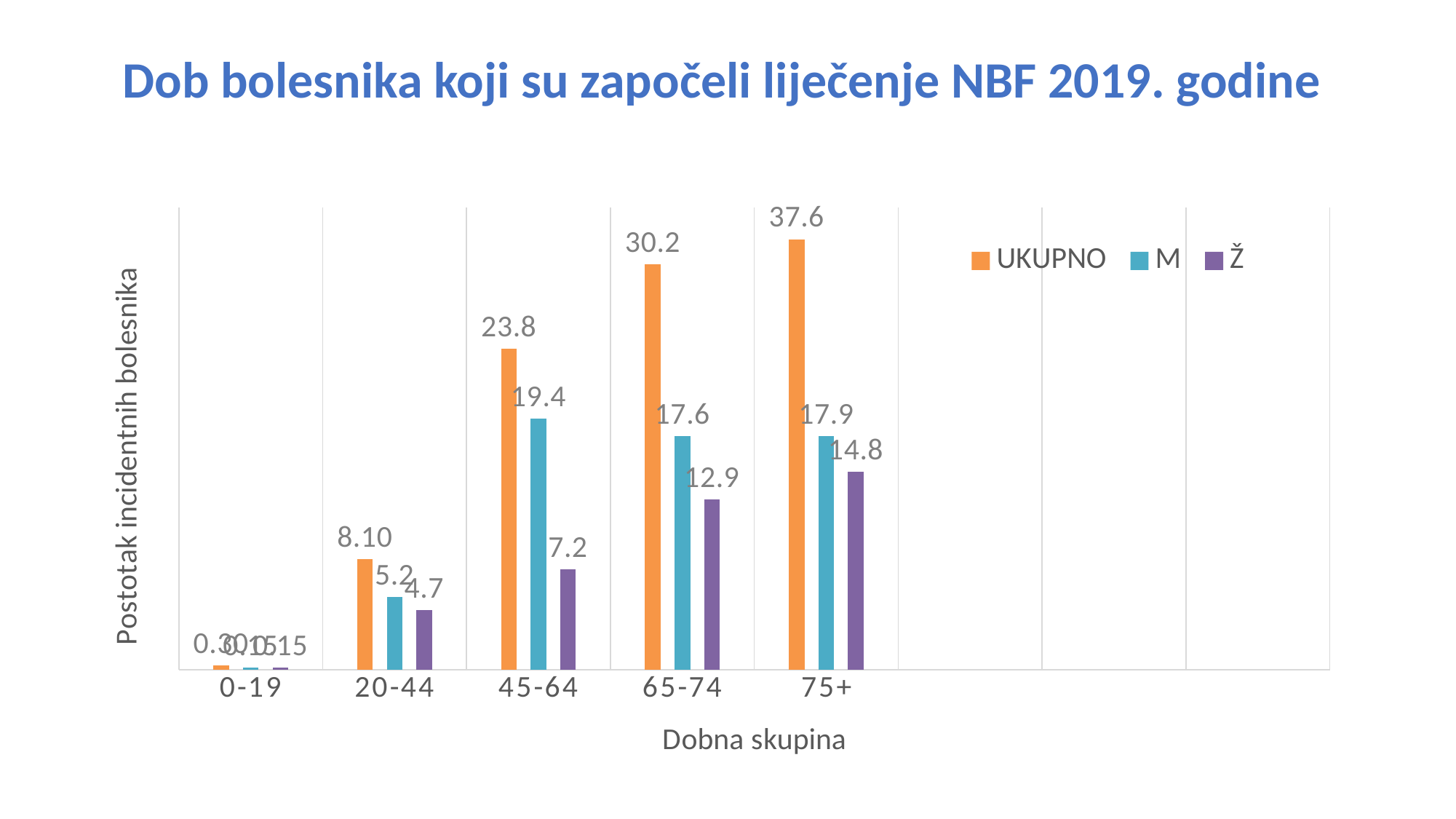
What is the UKUPNO value for the 20-44 age group? 8.10 Which age group has the lowest Ž value? 0-19 Which age group has the highest UKUPNO value? 75+ What kind of chart is shown on the slide? Bar chart What is the M value for the 45-64 age group? 19.4 What is the difference between the UKUPNO values for 75+ and 65-74? 7.4 Do the UKUPNO values rise or fall as the age groups increase along the x axis? Rise What is the UKUPNO value for the 75+ age group? 37.6 How many age groups are shown on the x axis? 5 How many series does the legend list? 3 What is the Ž value for the 65-74 age group? 12.9 Which is larger: the M value for 45-64 or the M value for 75+? M value for 45-64